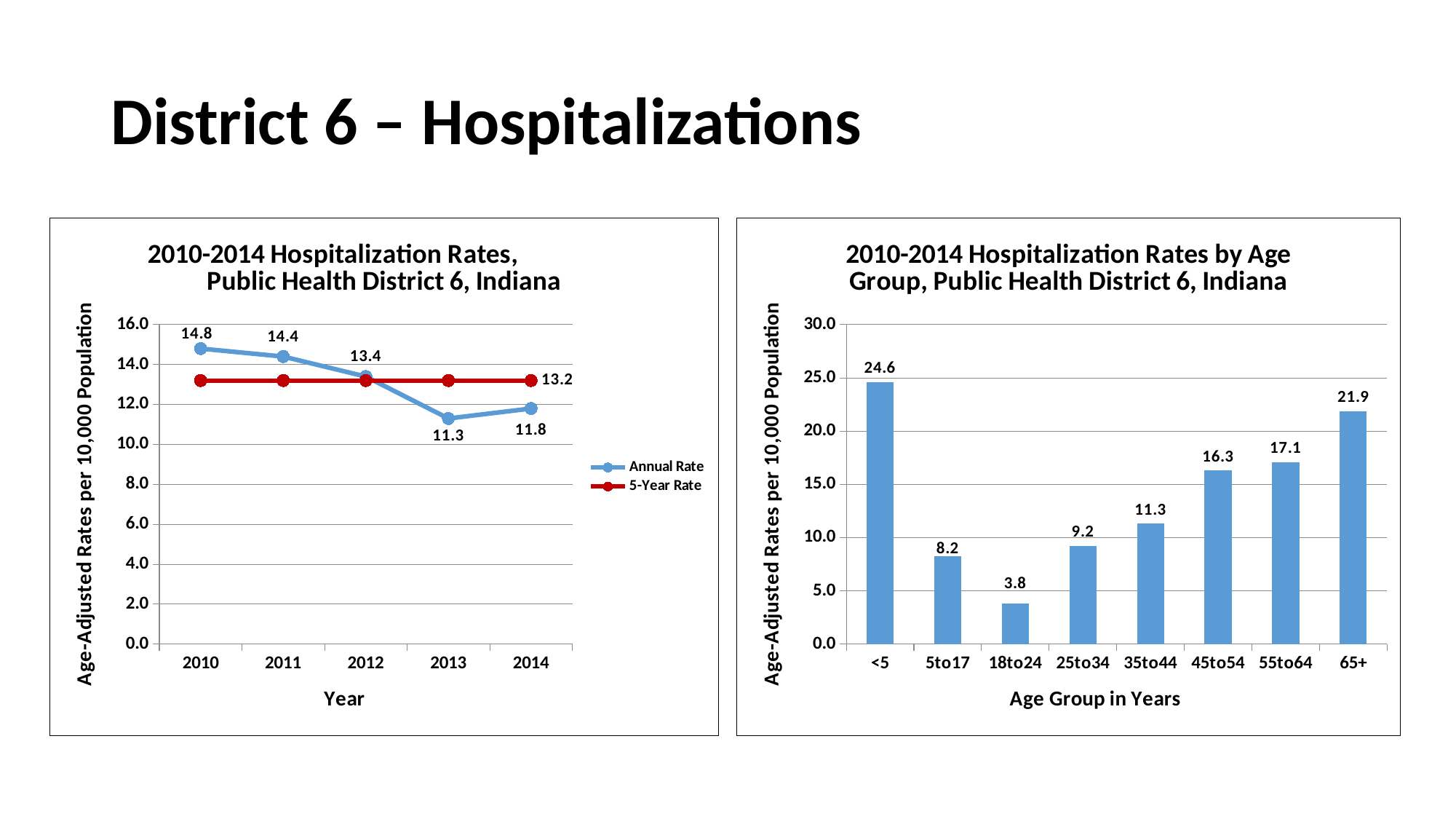
In the left chart (2010-2014 Hospitalization Rates, Public Health District 6, Indiana), which year has the lowest Annual Rate? 2013 In the right chart (2010-2014 Hospitalization Rates by Age Group), which is larger, the rate for 55to64 or for 65+? 65+ In the left chart (2010-2014 Hospitalization Rates, Public Health District 6, Indiana), does the Annual Rate generally rise or fall from 2010 to 2013? fall In the left chart (2010-2014 Hospitalization Rates, Public Health District 6, Indiana), what is the 5-Year Rate? 13.2 In the left chart (2010-2014 Hospitalization Rates, Public Health District 6, Indiana), how many series does the legend list? 2 In the right chart (2010-2014 Hospitalization Rates by Age Group), how many age groups are shown? 8 In the right chart (2010-2014 Hospitalization Rates by Age Group), what is the rate for the 45to54 age group? 16.3 In the left chart (2010-2014 Hospitalization Rates, Public Health District 6, Indiana), what kind of chart is it? line chart In the right chart (2010-2014 Hospitalization Rates by Age Group), which age group has the highest rate? <5 In the right chart (2010-2014 Hospitalization Rates by Age Group), which age group has the lowest rate? 18to24 In the left chart (2010-2014 Hospitalization Rates, Public Health District 6, Indiana), what is the Annual Rate for 2012? 13.4 In the left chart (2010-2014 Hospitalization Rates, Public Health District 6, Indiana), what is the difference between the Annual Rate in 2010 and in 2014? 3.0